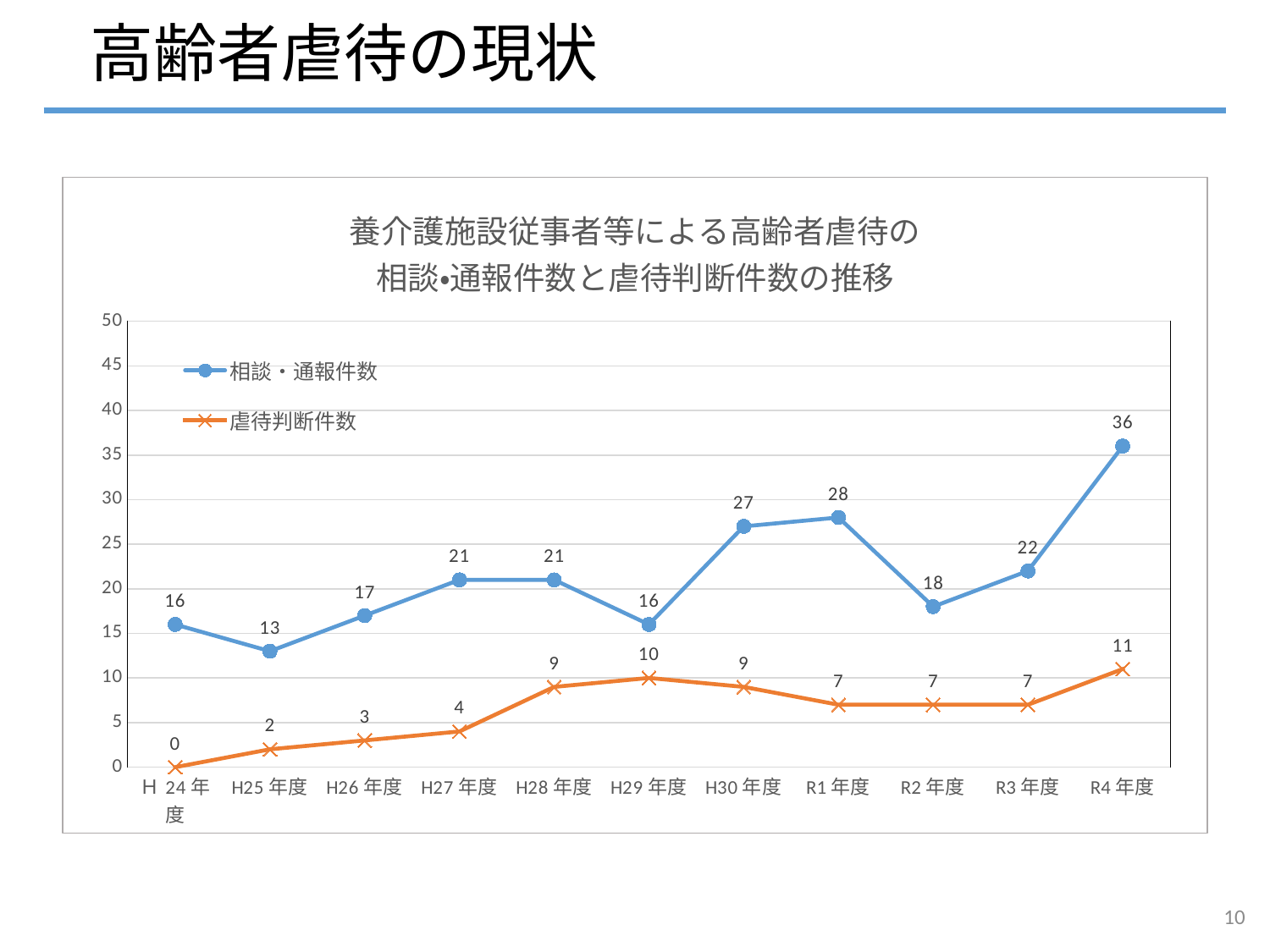
What is the value of 虐待判断件数 for H29年度? 10 How many series does the legend list? 2 Which year has the highest value for 相談・通報件数? R4年度 What is the value of 相談・通報件数 for R4年度? 36 Which is larger: 相談・通報件数 in H30年度 or in R1年度? R1年度 Which year has the lowest value for 虐待判断件数? H24年度 What kind of chart is shown on the slide? Line chart What is the difference between 相談・通報件数 and 虐待判断件数 in R4年度? 25 How many years are shown on the x axis? 11 Does 虐待判断件数 rise or fall from H24年度 to H29年度? Rise Which series is drawn with the orange line? 虐待判断件数 What is the value of 相談・通報件数 for H25年度? 13